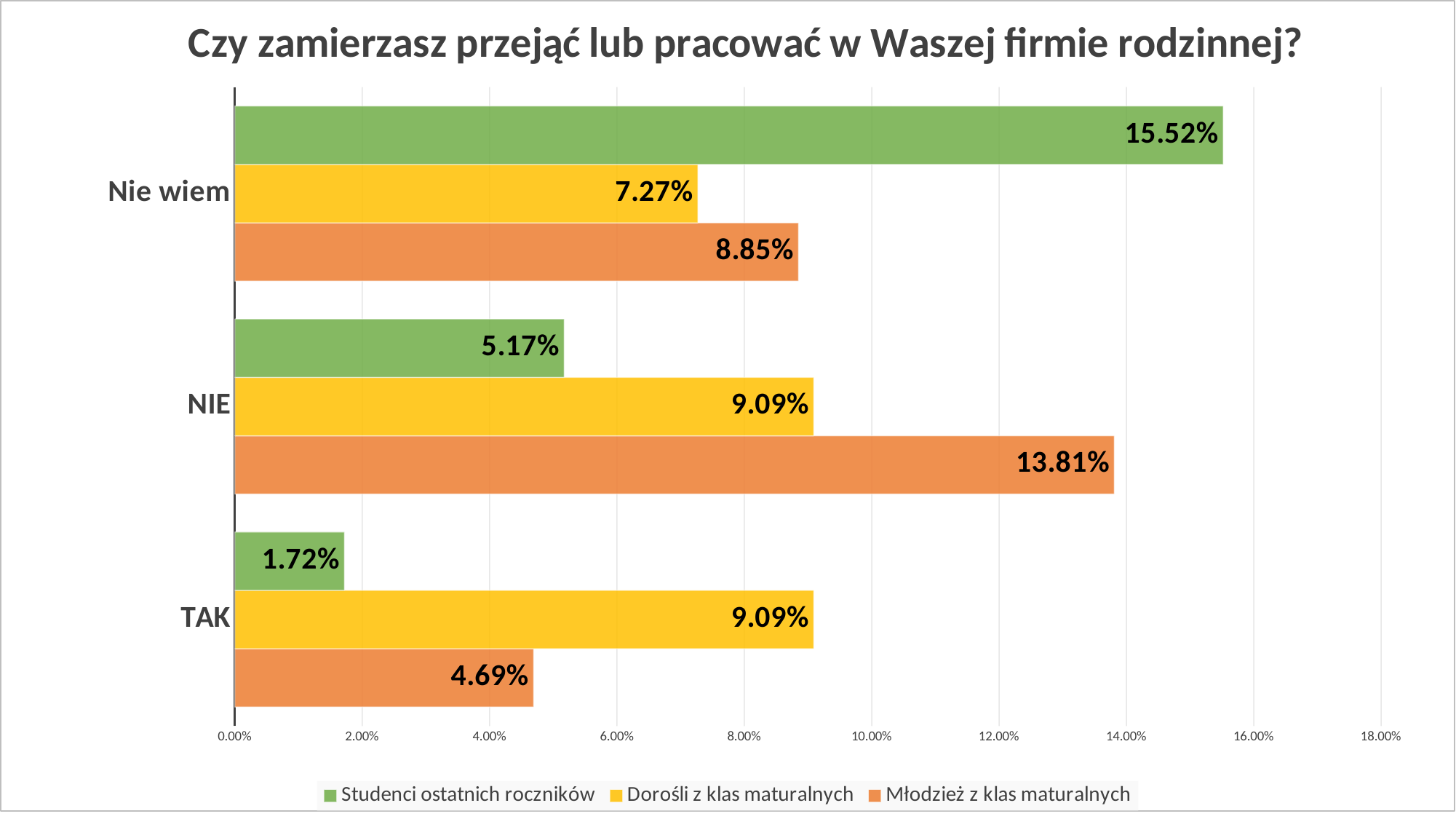
How many response categories are shown on the chart? 3 Which is larger in the Nie wiem category: Dorośli z klas maturalnych or Młodzież z klas maturalnych? Młodzież z klas maturalnych What is the value for Młodzież z klas maturalnych in the NIE category? 13.81% Is the value for Młodzież z klas maturalnych in the TAK category greater or less than 6.00%? less What is the value for Studenci ostatnich roczników in the TAK category? 1.72% How many series does the legend list? 3 What is the value for Dorośli z klas maturalnych in the TAK category? 9.09% Which series has the highest value in the Nie wiem category? Studenci ostatnich roczników What is the difference between the Młodzież z klas maturalnych and Dorośli z klas maturalnych values in the NIE category? 4.72% What type of chart is shown on the slide? Bar chart What is the value for Studenci ostatnich roczników in the Nie wiem category? 15.52% Which series has the lowest value in the TAK category? Studenci ostatnich roczników